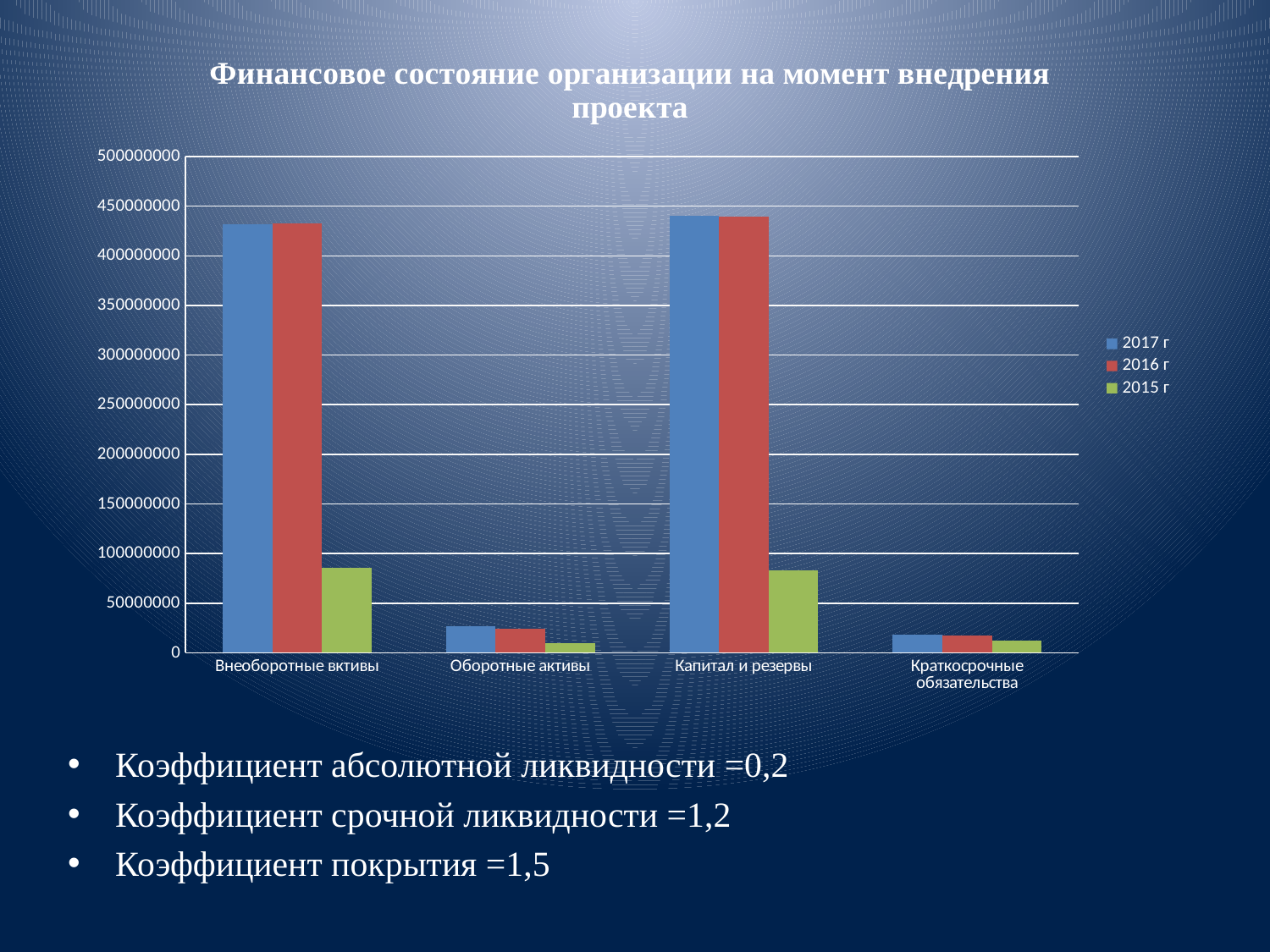
Which is larger for Внеоборотные активы: the value for 2017 г or the value for 2015 г? 2017 г Is the value for Капитал и резервы in 2016 г greater or less than 450000000? less How many series does the chart legend list? 3 Which series is shown in green in the chart? 2015 г Which category has the lowest value for the 2017 г series? Краткосрочные обязательства How many categories are shown on the x axis of the chart? 4 Which is larger for Оборотные активы: the value for 2016 г or the value for 2015 г? 2016 г What kind of chart is shown on the slide? bar chart Is the value for Внеоборотные активы in 2015 г greater or less than 100000000? less Is the value for Внеоборотные активы in 2017 г greater or less than 400000000? greater What is the title of the chart? Финансовое состояние организации на момент внедрения проекта